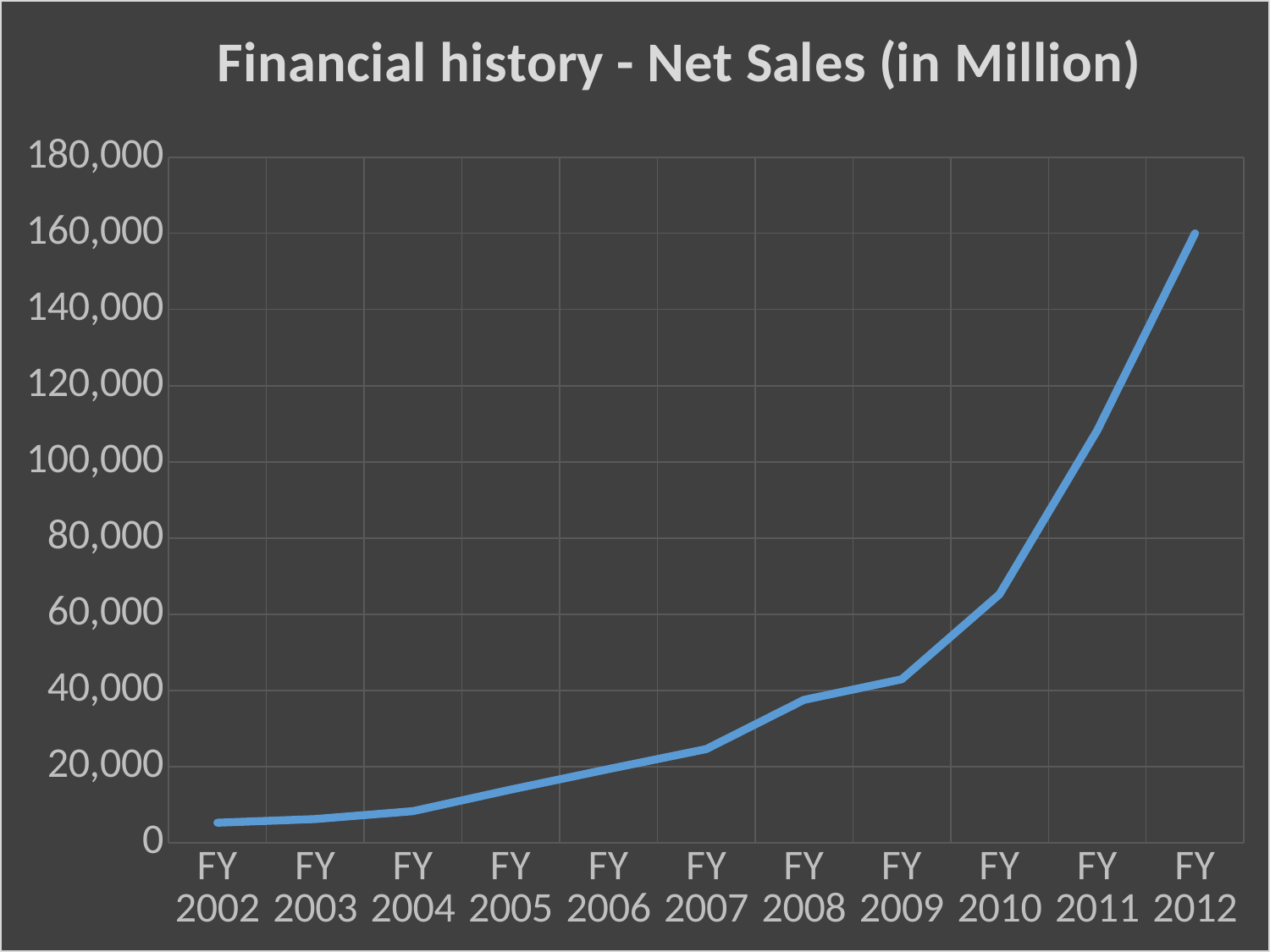
What is the title of the chart? Financial history - Net Sales (in Million) What kind of chart is shown on the slide? line chart Is the value for FY 2005 greater or less than 20,000? less Is the value for FY 2012 greater or less than 140,000? greater Do net sales rise or fall from FY 2002 to FY 2012? rise Which fiscal year has the lowest net sales? FY 2002 Which fiscal year has the highest net sales? FY 2012 Is the value for FY 2010 greater or less than 60,000? greater How many fiscal years are plotted on the x axis? 11 Which is larger, the net sales for FY 2010 or for FY 2008? FY 2010